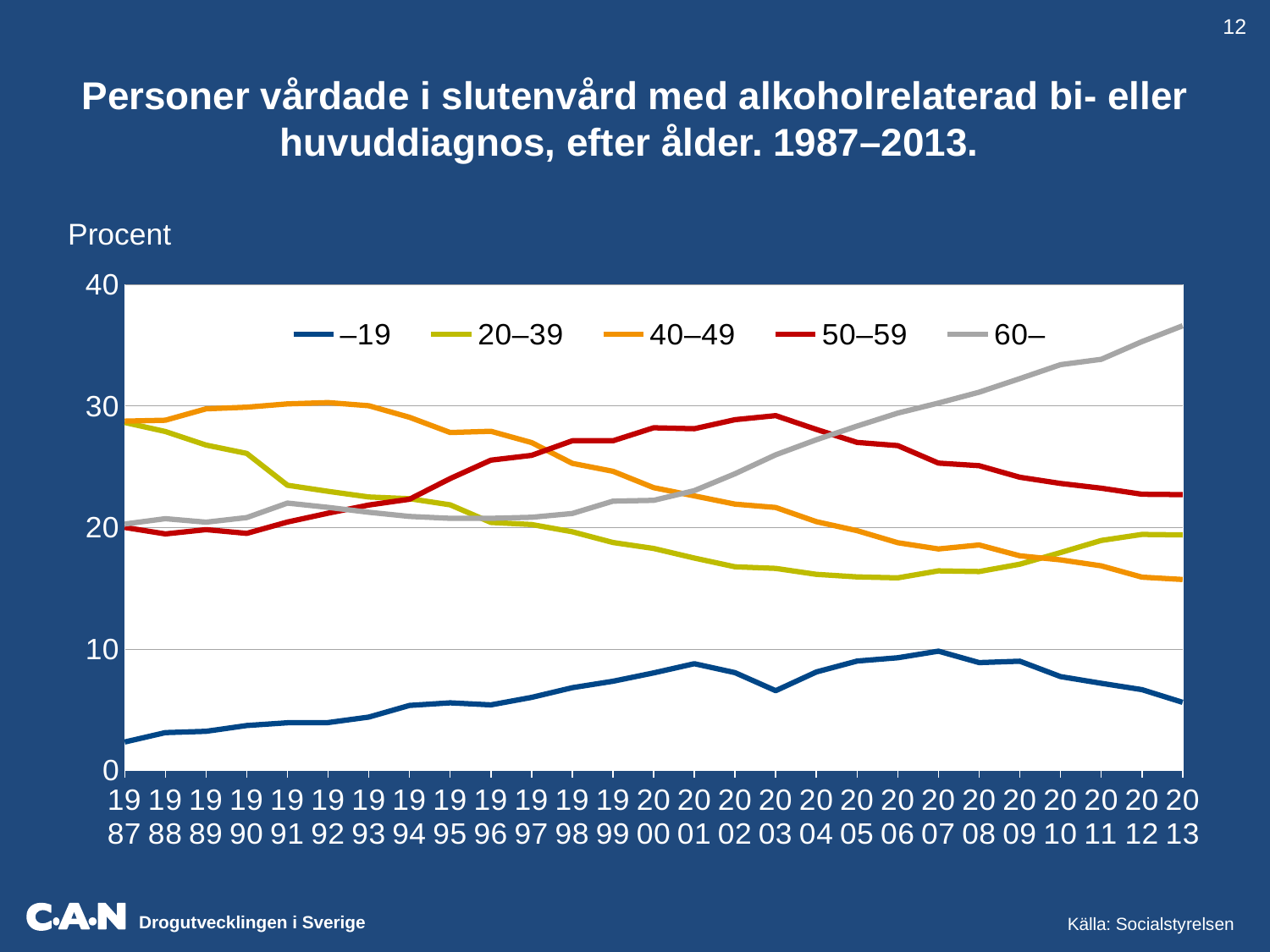
In 2013, which is larger: the value for the 50–59 group or the value for the 20–39 group? 50–59 Which age group has the highest value in 2013? 60– How many series does the legend list? 5 Is the value for the 60– group in 2013 greater or less than 30? greater Which age group has the lowest value in 1987? –19 Is the value for the –19 group in 1987 greater or less than 10? less What kind of chart is shown on the slide? line chart Does the value for the 40–49 group rise or fall from 1992 to 2013? fall How many years are plotted along the x axis? 27 What unit is shown as the label above the y axis? Procent Does the value for the 60– group rise or fall from 1987 to 2013? rise Is the value for the 40–49 group in 2013 greater or less than 20? less